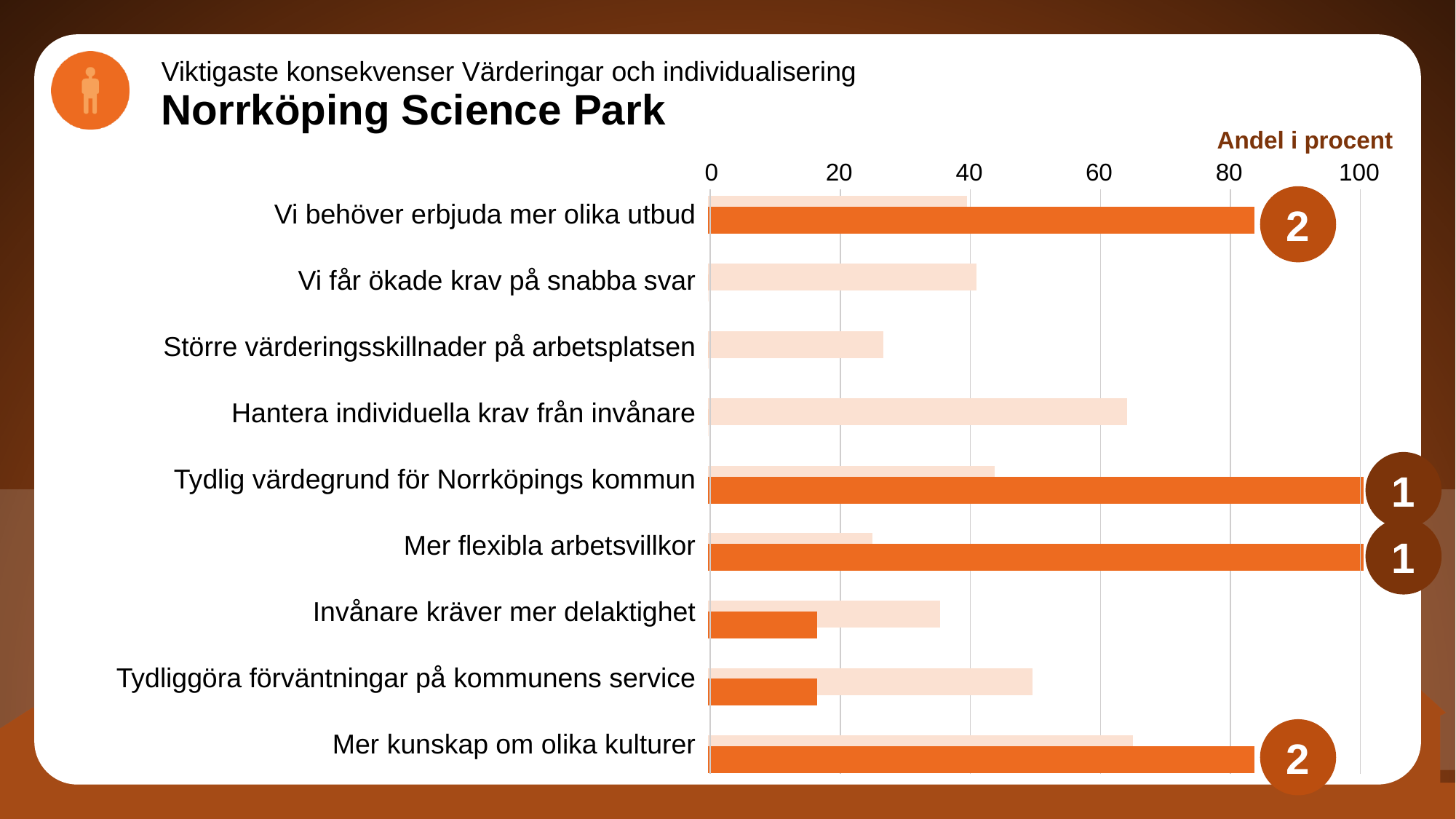
What is the value of the dark orange bar for "Tydlig värdegrund för Norrköpings kommun"? 100 What is the label shown above the horizontal axis of the chart? Andel i procent Is the light orange bar for "Större värderingsskillnader på arbetsplatsen" greater or less than 40? less How many categories are listed on the vertical axis of the chart? 9 Is the light orange bar for "Hantera individuella krav från invånare" greater or less than 60? greater What kind of chart is shown on the slide? bar chart Which has the longer light orange bar: "Hantera individuella krav från invånare" or "Vi får ökade krav på snabba svar"? Hantera individuella krav från invånare Is the dark orange bar for "Invånare kräver mer delaktighet" greater or less than 20? less Which has the longer dark orange bar: "Mer kunskap om olika kulturer" or "Tydliggöra förväntningar på kommunens service"? Mer kunskap om olika kulturer What is the value of the dark orange bar for "Mer flexibla arbetsvillkor"? 100 What is the bold title text shown at the top of the slide? Norrköping Science Park